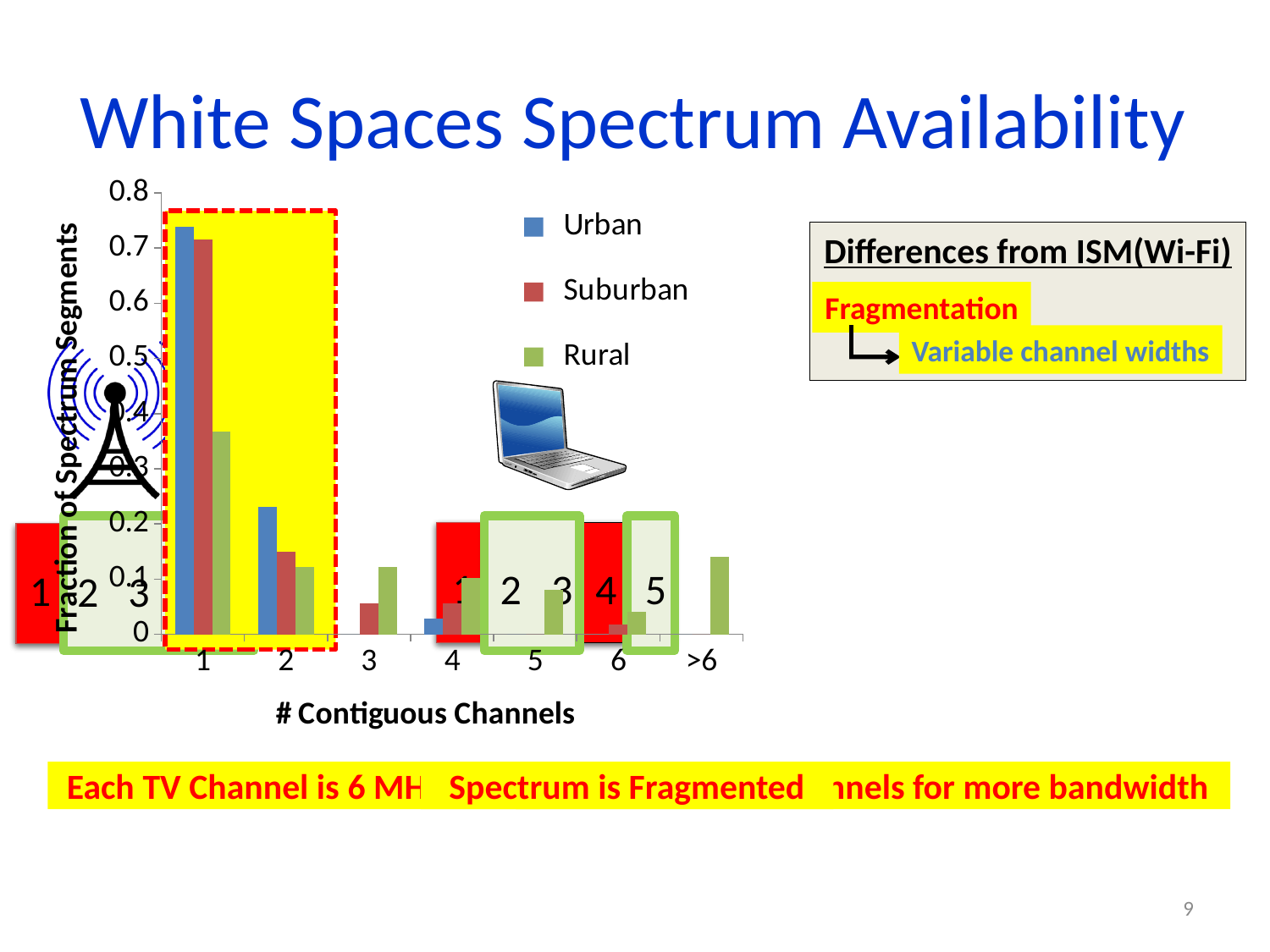
Do the Urban values rise or fall as the number of contiguous channels increases from 1 to 3? fall What is the title of the x axis of the chart? # Contiguous Channels Which is larger: the Rural value for 1 contiguous channel or the Urban value for 2 contiguous channels? Rural value for 1 contiguous channel Is the Suburban value for 1 contiguous channel greater or less than 0.6? greater Which series has the lowest value for 1 contiguous channel? Rural How many categories are shown on the x axis of the chart? 7 Is the Urban value for 2 contiguous channels greater or less than 0.3? less How many series does the chart legend list? 3 Is the Rural value for 1 contiguous channel greater or less than 0.4? less What kind of chart is shown on the slide? bar chart For which number of contiguous channels is the Urban value highest? 1